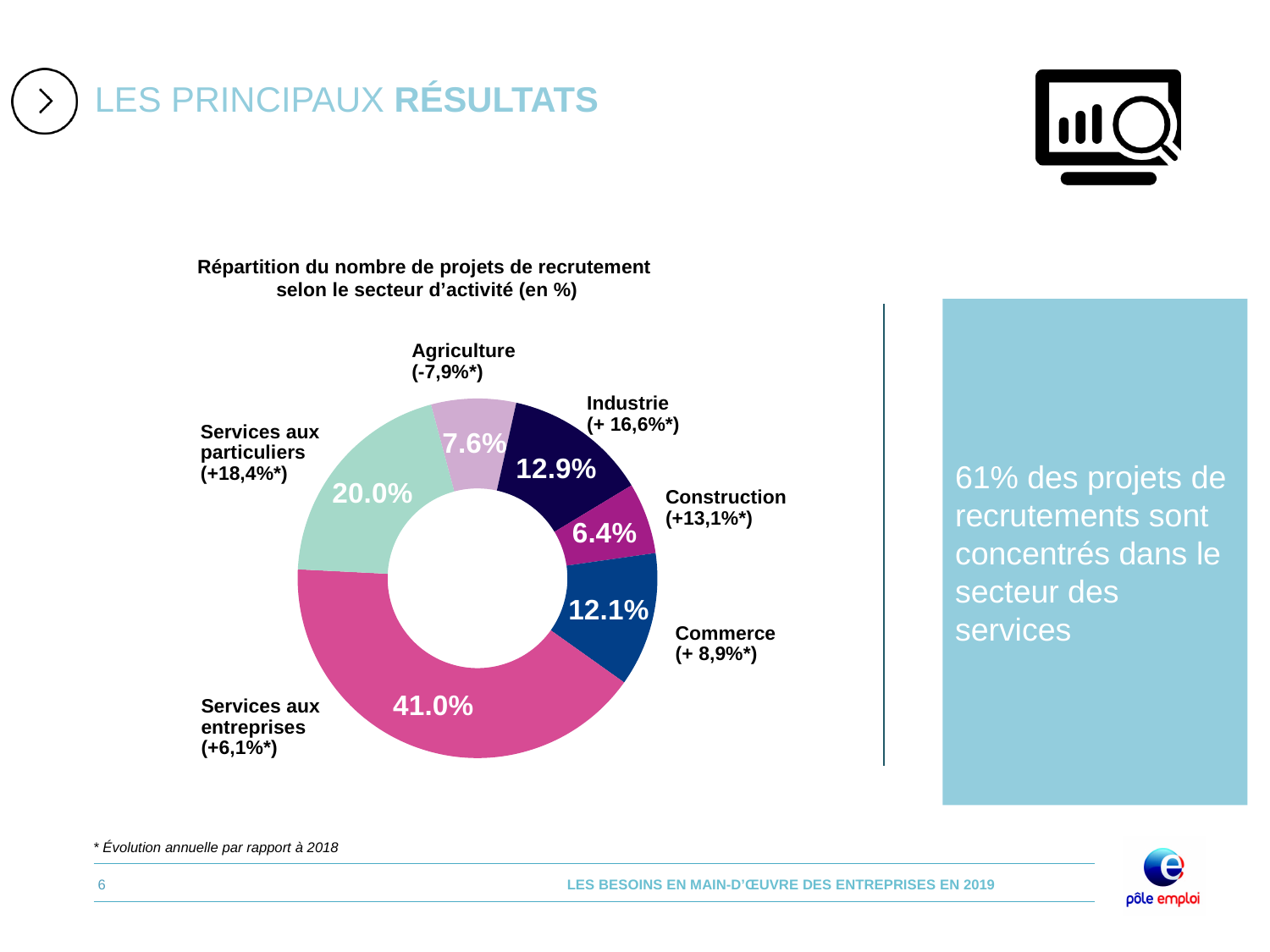
What share of recruitment projects does the Services aux entreprises sector account for? 41.0% How many sectors are shown in the chart? 6 Which sector has the smallest share of recruitment projects? Construction What is the value shown for Agriculture? 7.6% Which sector has the largest share of recruitment projects? Services aux entreprises What percentage is shown for the Construction sector? 6.4% What is the value for Commerce? 12.1% What annual change is indicated next to the Industrie label? + 16,6% What kind of chart is used on this slide? Doughnut chart What is the combined share of Services aux entreprises and Services aux particuliers? 61.0% What is the difference between the shares of Services aux entreprises and Services aux particuliers? 21.0 percentage points Which has a larger share, Industrie or Commerce? Industrie